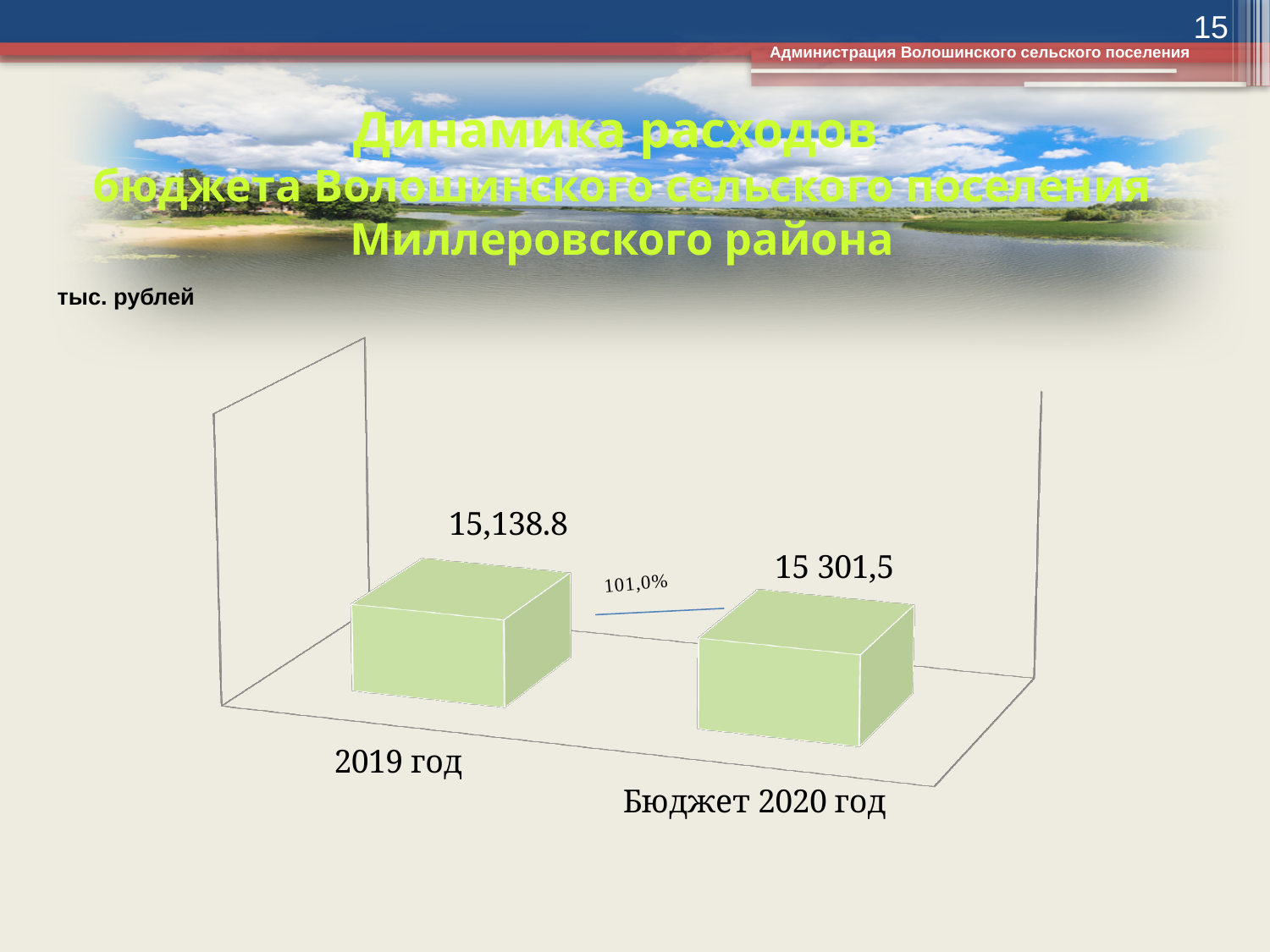
What is the value for Бюджет 2020 год? 15 301,5 Do the values rise or fall from 2019 год to Бюджет 2020 год? Rise How many categories are shown in the chart? 2 What is the value for 2019 год? 15,138.8 What kind of chart is shown on the slide? Bar chart In what units are the chart values given? тыс. рублей What percentage is shown on the arrow between the two bars? 101,0% Which category has the lowest value? 2019 год Which category has the highest value? Бюджет 2020 год What is the difference between the value for Бюджет 2020 год and the value for 2019 год? 162.7 Which category has the higher value, 2019 год or Бюджет 2020 год? Бюджет 2020 год